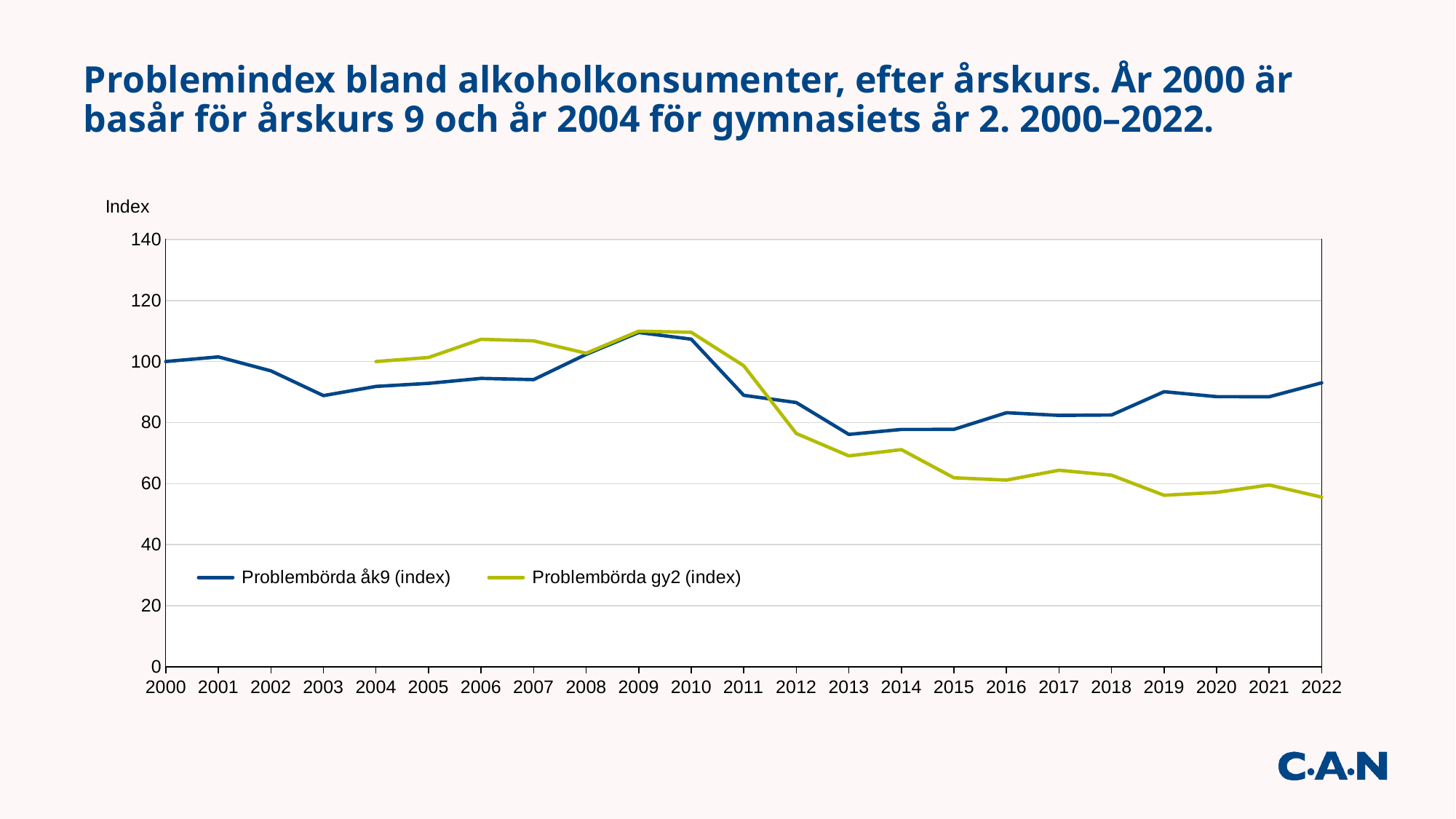
In 2006, which series has the higher value, Problembörda åk9 (index) or Problembörda gy2 (index)? Problembörda gy2 (index) What kind of chart is shown on the slide? Line chart How many series does the legend list? 2 Is the value for Problembörda gy2 (index) in 2006 greater or less than 100? greater What is the label on the y axis? Index What is the value of Problembörda gy2 (index) in 2004? 100 What is the value of Problembörda åk9 (index) in 2000? 100 Is the value for Problembörda åk9 (index) in 2013 greater or less than 80? less Is the value for Problembörda gy2 (index) in 2022 greater or less than 60? less In 2022, which series has the higher value, Problembörda åk9 (index) or Problembörda gy2 (index)? Problembörda åk9 (index) How many years are shown on the x axis? 23 Does Problembörda gy2 (index) rise or fall between 2010 and 2015? Fall